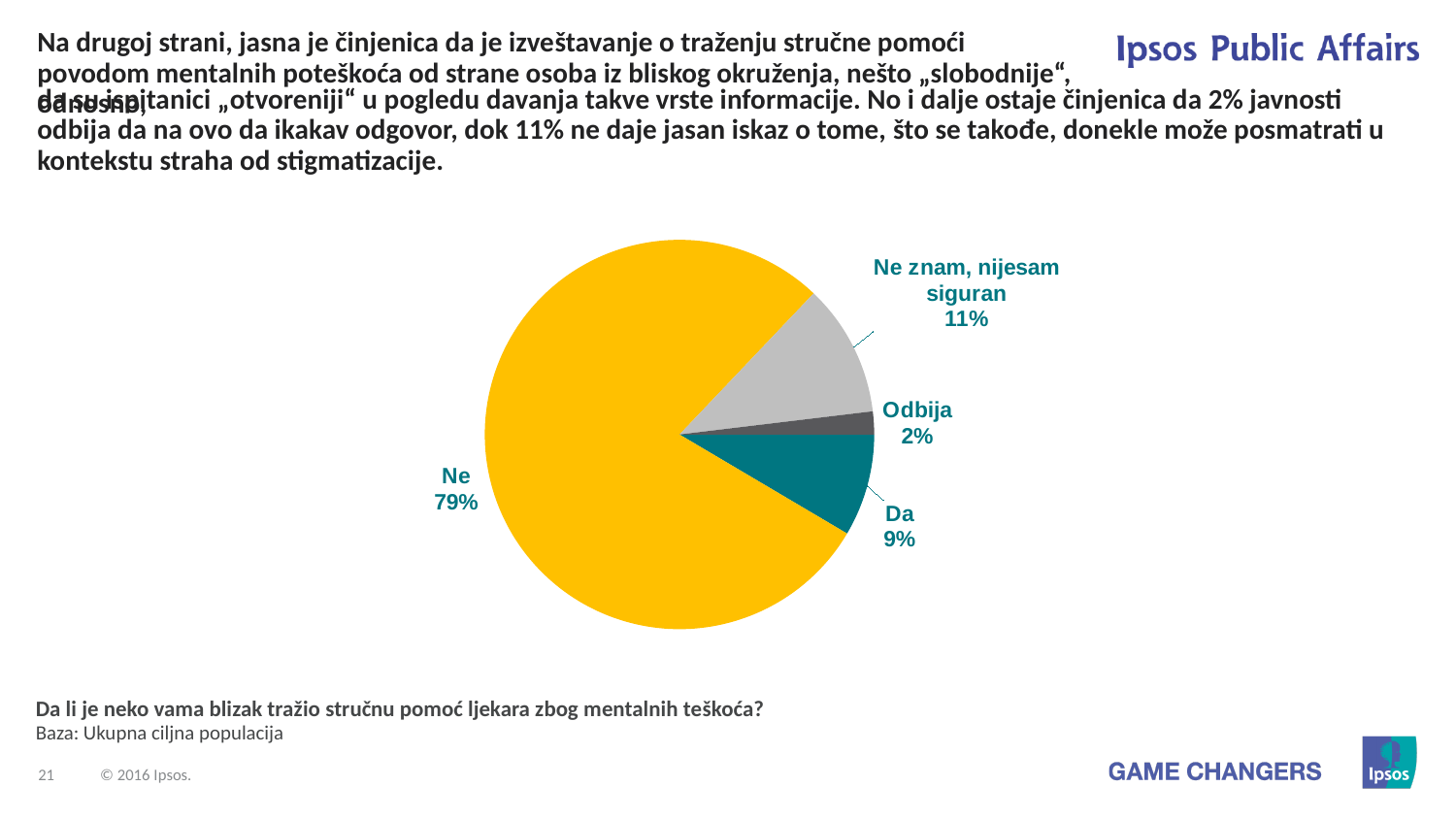
Which slice of the pie is the smallest? Odbija Which is larger, the share for "Ne znam, nijesam siguran" or the share for "Da"? Ne znam, nijesam siguran What share of respondents answered "Ne"? 79% What is the difference in percentage points between "Ne" and "Da"? 70 What share of respondents answered "Da"? 9% What is the difference in percentage points between "Ne znam, nijesam siguran" and "Odbija"? 9 What share of respondents answered "Odbija"? 2% What colour is the "Ne" slice of the pie? yellow What kind of chart is shown on the slide? pie chart Which slice of the pie is the largest? Ne How many slices does the pie chart have? 4 What share of respondents answered "Ne znam, nijesam siguran"? 11%